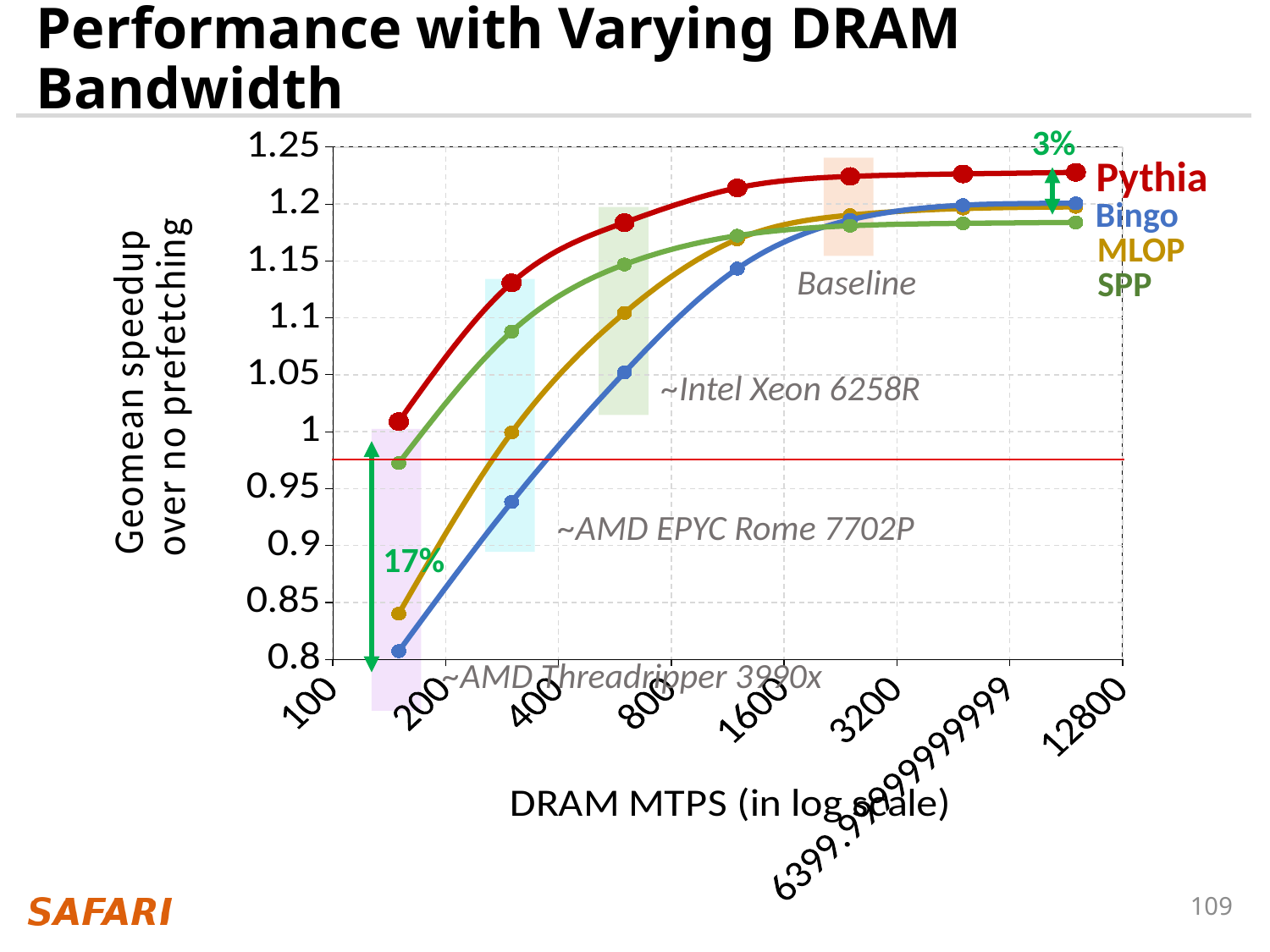
How many data points are plotted for the Pythia series? 7 Is the geomean speedup for Bingo at the lowest DRAM bandwidth plotted greater or less than 0.85? less Which series has the highest geomean speedup at the lowest DRAM bandwidth plotted? Pythia Is the geomean speedup for SPP at the highest DRAM bandwidth plotted greater or less than 1.2? less Do the geomean speedup values rise or fall as DRAM MTPS increases? rise How many series does the chart's legend list? 4 Is the geomean speedup for Pythia at the highest DRAM bandwidth plotted greater or less than 1.2? greater At the lowest DRAM bandwidth plotted, which has the larger geomean speedup, SPP or MLOP? SPP Which series has the lowest geomean speedup at the lowest DRAM bandwidth plotted? Bingo What is the label of the x axis? DRAM MTPS (in log scale) What percentage gap is annotated between Pythia and the other prefetchers at the lowest DRAM bandwidth? 17% What kind of chart is shown on the slide? line chart